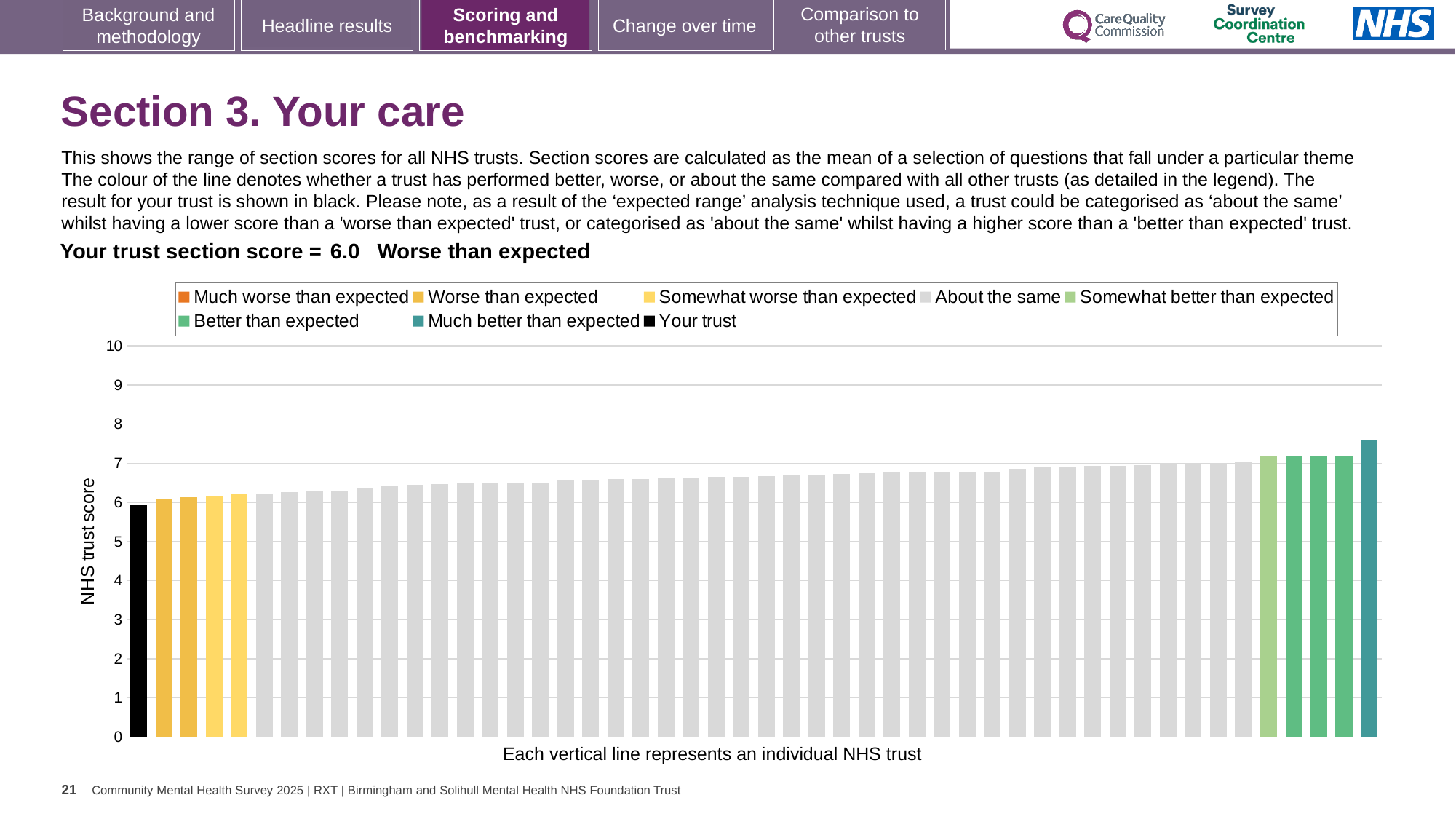
Do the bar values rise or fall from left to right across the chart? rise Is the value of the tallest bar (Much better than expected) greater or less than 7? greater How many bars are coloured as 'Worse than expected'? 2 What is the label on the vertical axis of the chart? NHS trust score Which legend category does the lowest bar on the chart belong to? Your trust Is the value of the black 'Your trust' bar greater or less than 7? less What kind of chart is shown on the slide? bar chart How many entries does the chart legend list? 8 Which performance category is your trust placed in for this section? Worse than expected What is the section score for your trust? 6.0 How many bars are coloured as 'Better than expected'? 3 Which legend category does the highest bar on the chart belong to? Much better than expected